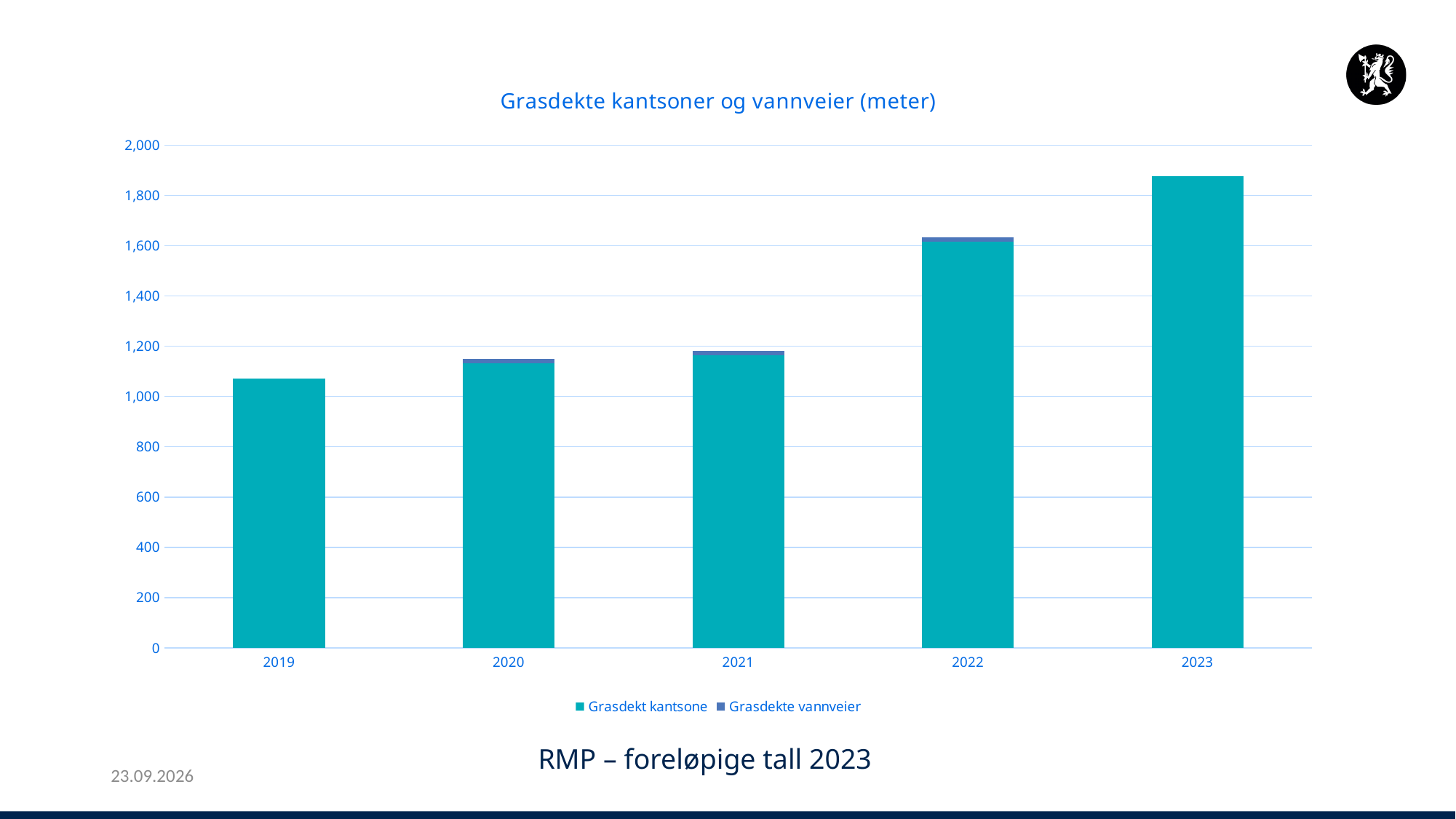
Is the total bar for 2021 greater or less than 1,200? less How many series does the legend list? 2 Is the total bar for 2022 greater or less than 1,400? greater What is the title of the chart? Grasdekte kantsoner og vannveier (meter) How many years are shown on the x axis? 5 Is the total bar for 2023 greater or less than 1,800? greater Do the total bar values rise or fall from 2019 to 2023? rise Which year has the highest total bar? 2023 Which is larger, the total bar for 2022 or the total bar for 2021? 2022 What type of chart is shown on the slide? Stacked bar chart Which year has the lowest total bar? 2019